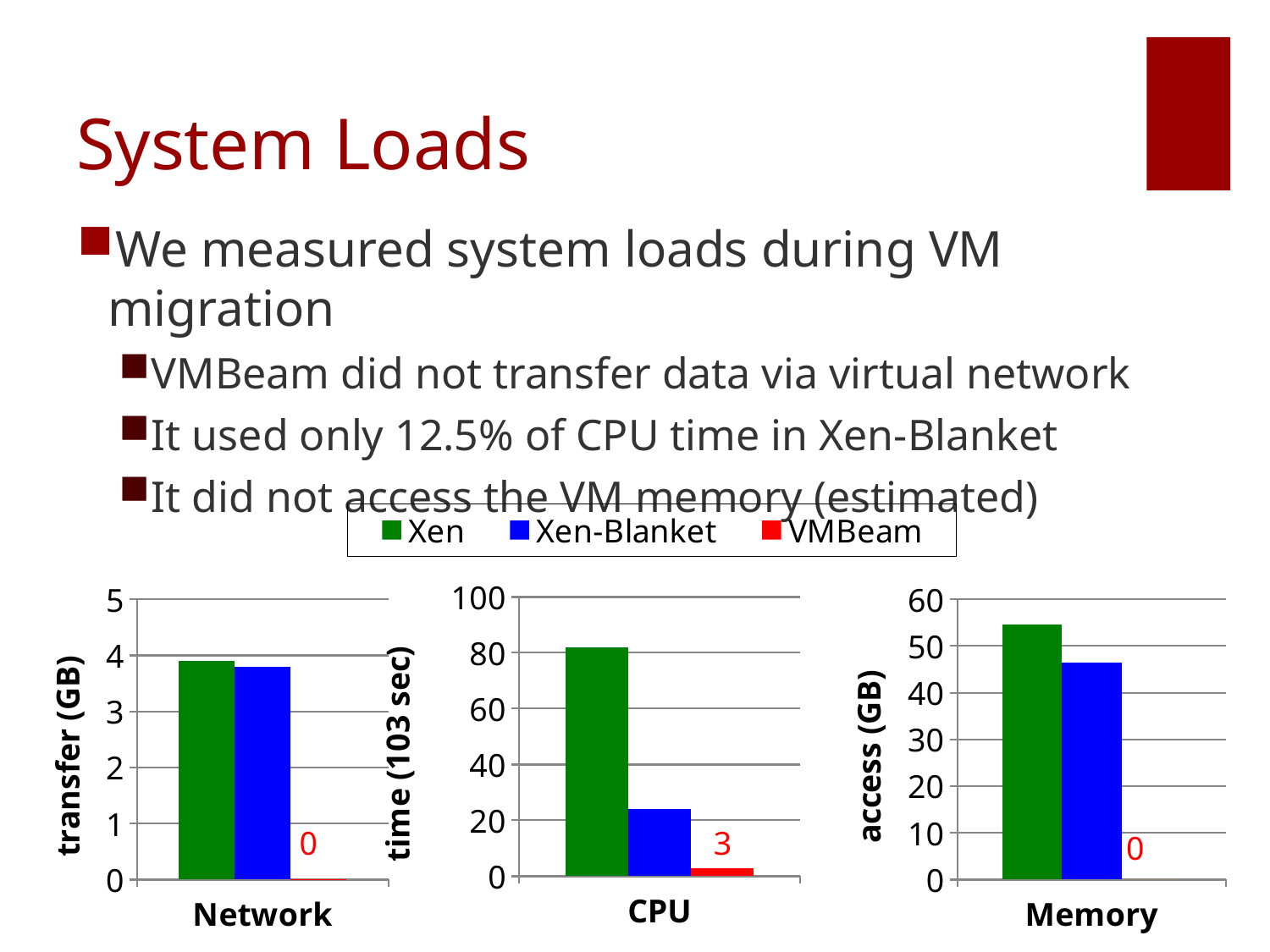
In the CPU chart, is the value for Xen greater or less than 60? greater In the Memory chart, is the value for Xen-Blanket greater or less than 40? greater How many series does the legend list for the charts? 3 What kind of chart is the CPU chart? bar chart In the CPU chart, which series has the lowest value? VMBeam In the Memory chart, which series has the highest value? Xen In the Memory chart, what is the value for VMBeam? 0 In the CPU chart, what is the value for VMBeam? 3 In the CPU chart, which series has the highest value? Xen In the CPU chart, is the value for Xen-Blanket greater or less than 40? less In the Network chart, what is the value for VMBeam? 0 In the Memory chart, which is larger, the value for Xen or the value for Xen-Blanket? Xen